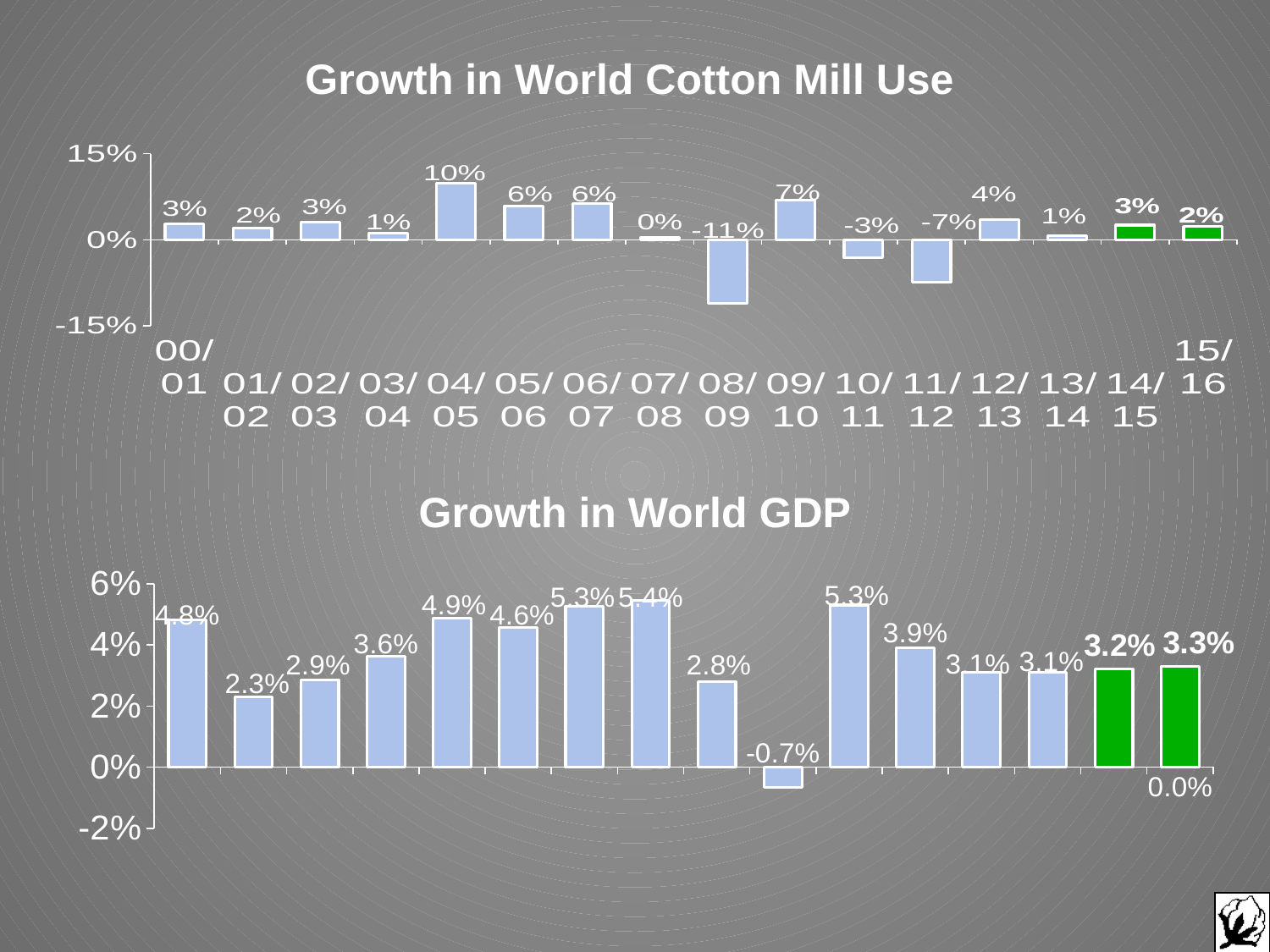
In the Growth in World GDP chart, what is the lowest value labelled? -0.7% In the Growth in World Cotton Mill Use chart, which season has the highest growth? 04/05 In the Growth in World Cotton Mill Use chart, which season has the lowest growth? 08/09 In the Growth in World Cotton Mill Use chart, what is the value for 04/05? 10% In the Growth in World Cotton Mill Use chart, what is the difference between the values for 09/10 and 11/12? 14 percentage points In the Growth in World GDP chart, what is the highest value labelled? 5.4% In the Growth in World Cotton Mill Use chart, what colour are the bars for 14/15 and 15/16? Green How many seasons are shown on the x axis of the Growth in World Cotton Mill Use chart? 16 In the Growth in World Cotton Mill Use chart, which is larger, the value for 05/06 or the value for 12/13? 05/06 In the Growth in World GDP chart, what is the value of the first bar on the left? 4.8% In the Growth in World Cotton Mill Use chart, what is the value for 08/09? -11% What kind of chart is the Growth in World GDP chart? Bar chart